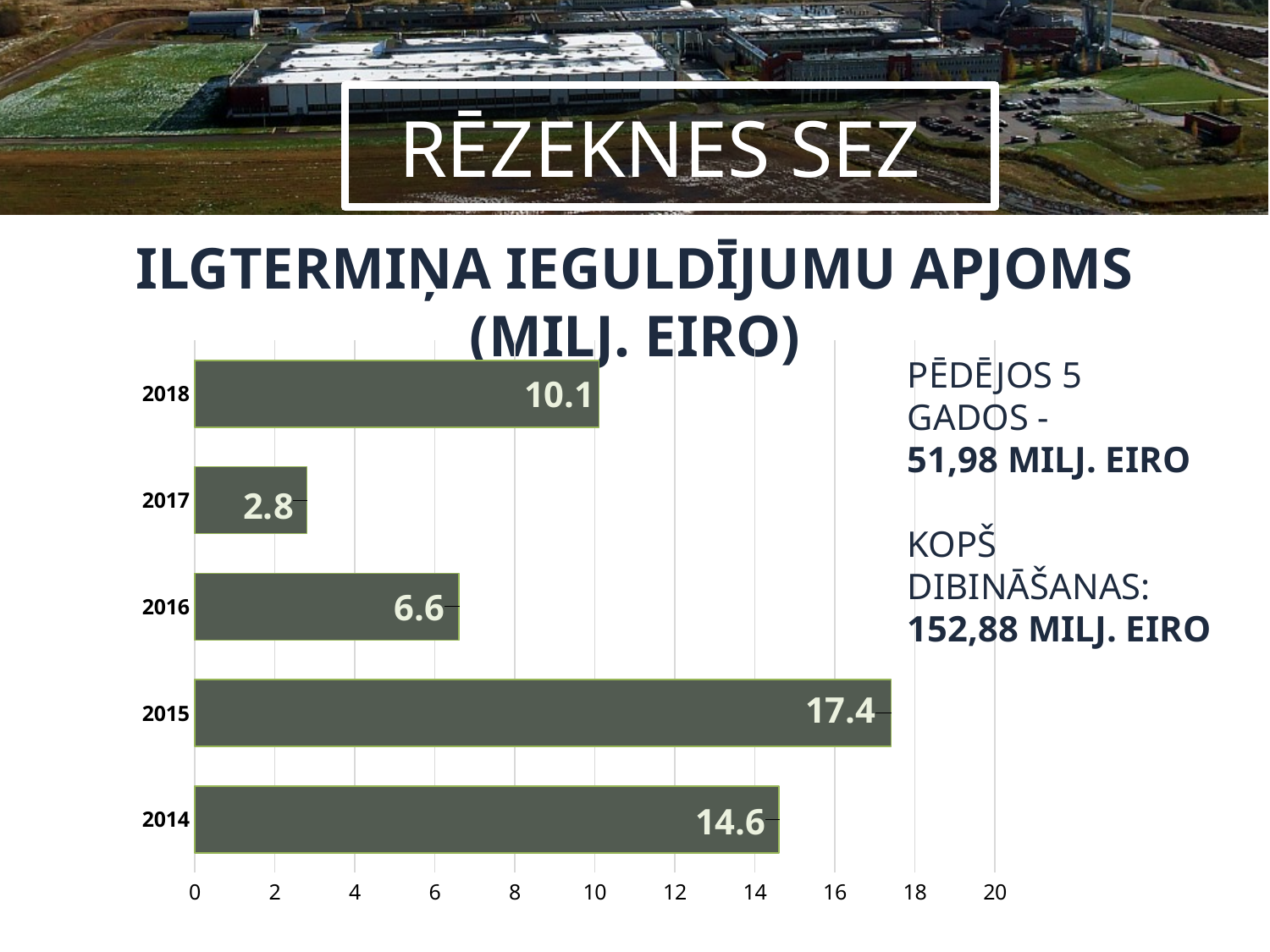
Which year has the lowest value? 2017 What is the value for 2018? 10.1 Which is larger, the value for 2014 or the value for 2018? 2014 What is the value for 2017? 2.8 Which year has the highest value? 2015 What kind of chart is shown on the slide? bar chart Is the value for 2016 greater or less than 8? less What is the difference between the values for 2015 and 2014? 2.8 How many years are shown in the chart? 5 What is the title of the chart? ILGTERMIŅA IEGULDĪJUMU APJOMS (MILJ. EIRO) What is the value for 2015? 17.4 What is the difference between the values for 2018 and 2016? 3.5